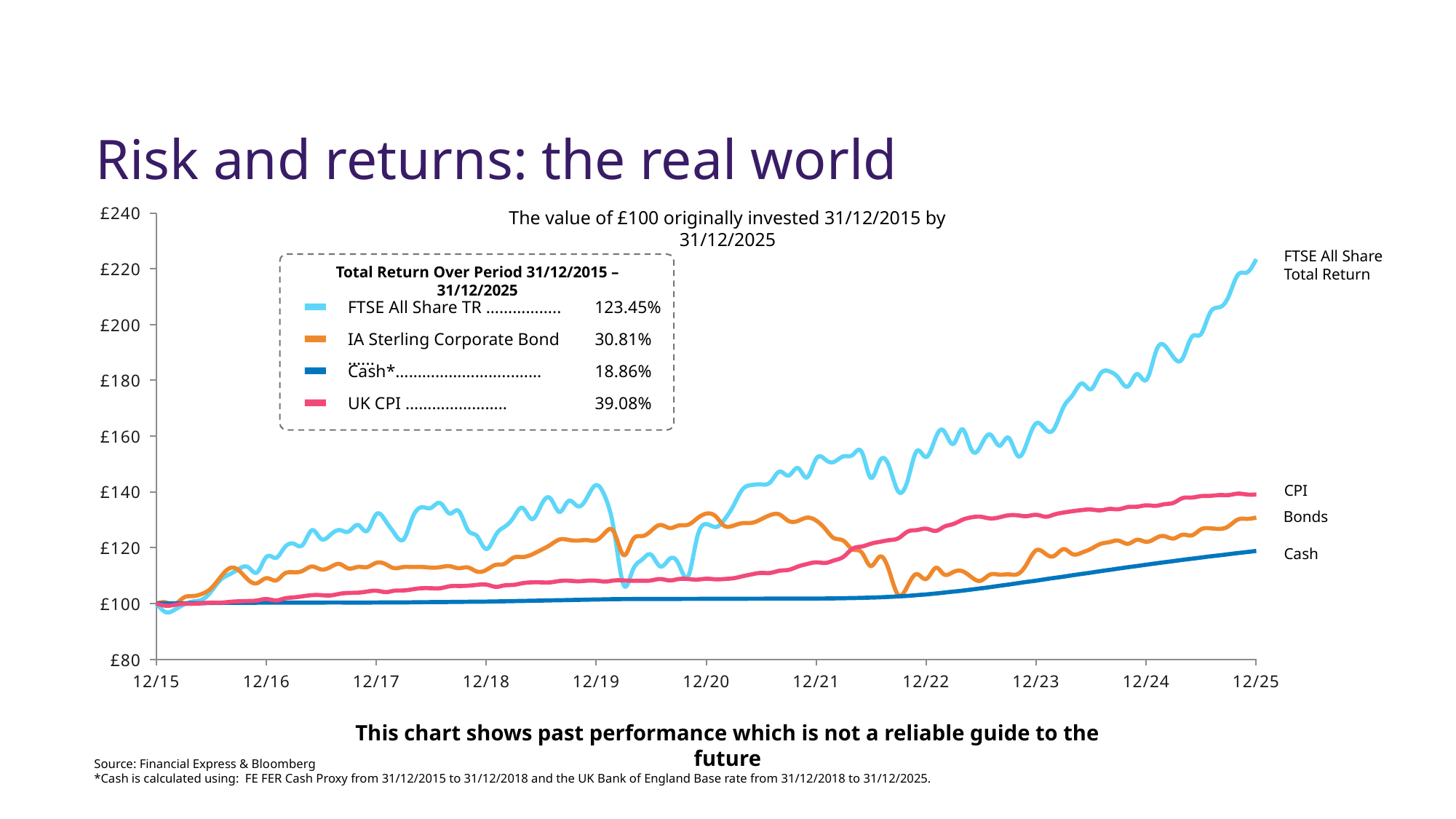
Which has the larger total return over the period, UK CPI or IA Sterling Corporate Bond? UK CPI What kind of chart is shown on the slide? line chart Which series has the lowest total return over the period? Cash* What is the total return over the period for IA Sterling Corporate Bond? 30.81% What is the difference between the total return of UK CPI and that of IA Sterling Corporate Bond? 8.27% What is the total return over the period for UK CPI? 39.08% What is the title of the chart? The value of £100 originally invested 31/12/2015 by 31/12/2025 What is the total return over the period for FTSE All Share TR? 123.45% Which series has the highest total return over the period? FTSE All Share TR What is the total return over the period for Cash*? 18.86% How many series does the legend box list? 4 Is the value of the FTSE All Share Total Return line at 12/25 greater or less than £200? greater